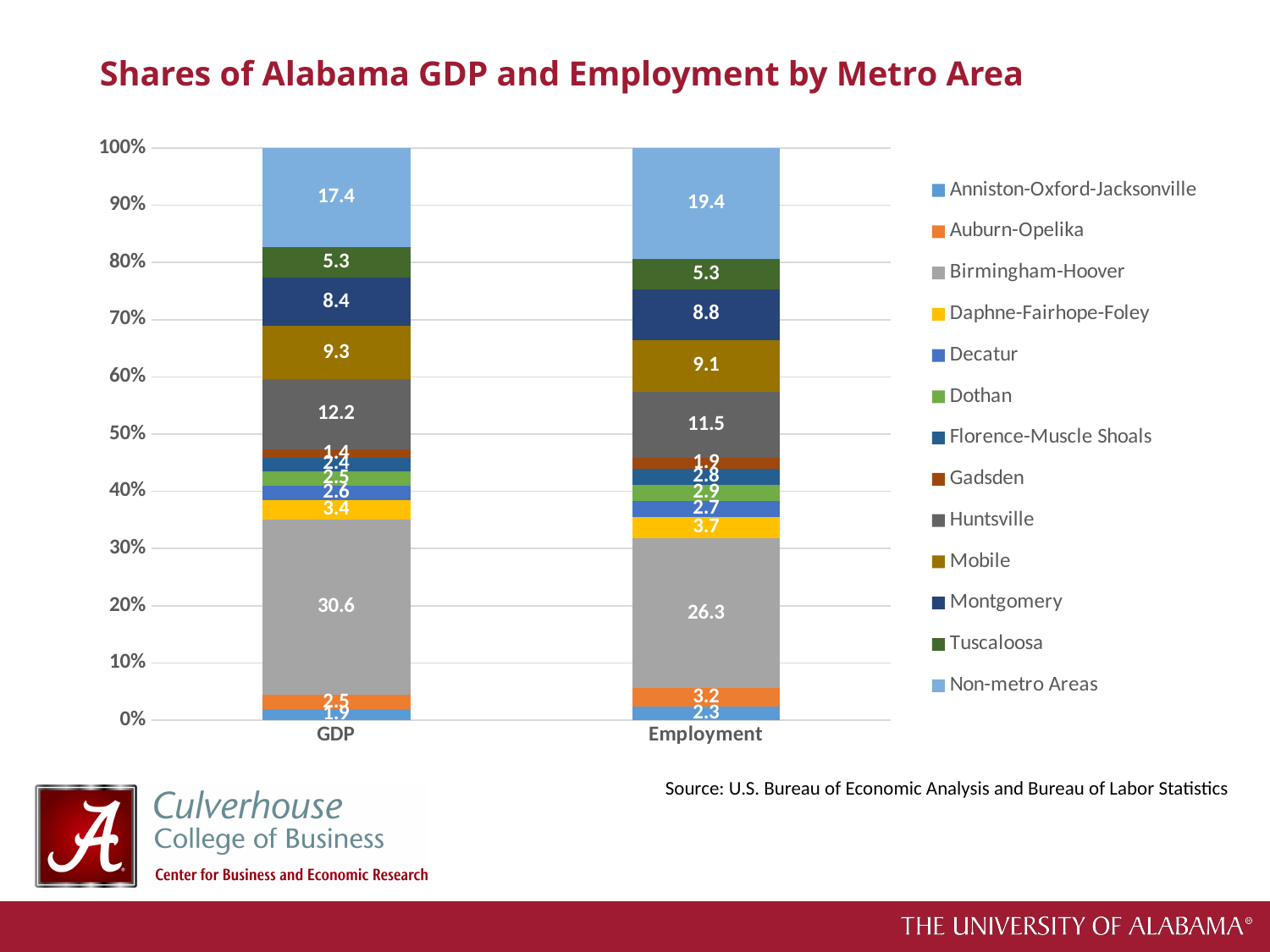
What is the Non-metro Areas share of employment? 19.4 What is the Birmingham-Hoover share of Alabama employment? 26.3 Is the Huntsville share larger for GDP or for employment? GDP Which metro area has the largest share of Alabama GDP? Birmingham-Hoover How much larger is the Birmingham-Hoover share of GDP than its share of employment? 4.3 What is the Mobile share of employment? 9.1 What type of chart is shown on the slide? Stacked bar chart What is the Huntsville share of GDP? 12.2 How many bars are shown in the chart? 2 Is the Montgomery share larger for GDP or for employment? Employment What is the Birmingham-Hoover share of Alabama GDP? 30.6 How many series does the legend list? 13